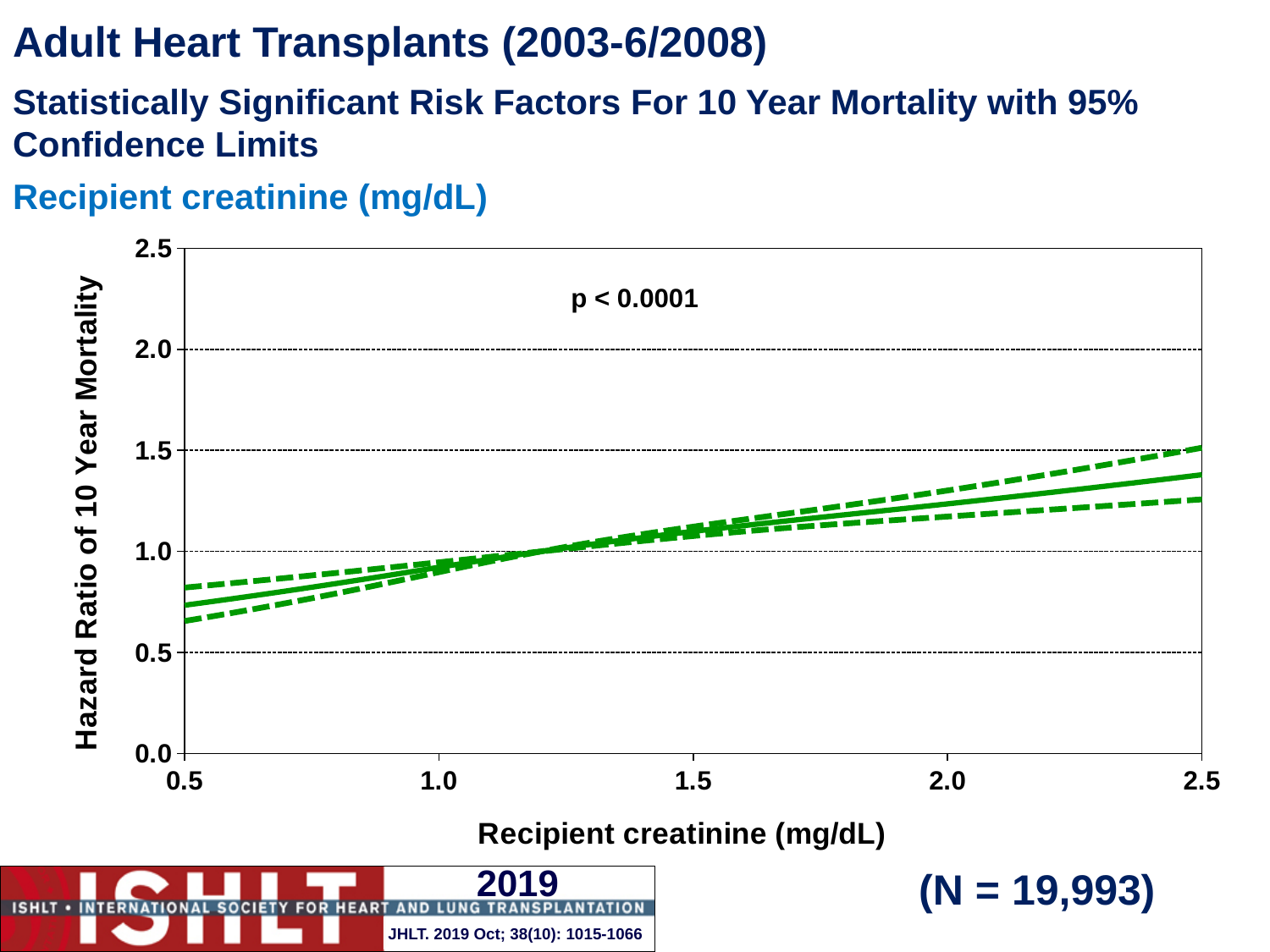
What is the label of the y axis? Hazard Ratio of 10 Year Mortality Does the hazard ratio of 10 year mortality rise or fall as recipient creatinine increases along the x axis? rise What is the highest value shown on the x axis? 2.5 Is the hazard ratio for a recipient creatinine of 0.5 mg/dL greater or less than 0.5? greater What sample size (N) is printed on the slide? N = 19,993 What kind of chart is shown on the slide? line chart Is the hazard ratio for a recipient creatinine of 2.5 mg/dL greater or less than 1.0? greater Is the hazard ratio for a recipient creatinine of 2.5 mg/dL greater or less than 1.5? less Is the hazard ratio higher at a recipient creatinine of 2.0 mg/dL or at 1.0 mg/dL? 2.0 mg/dL How many lines are plotted on the chart (the estimate plus its confidence limits)? 3 What p-value is printed on the chart? p < 0.0001